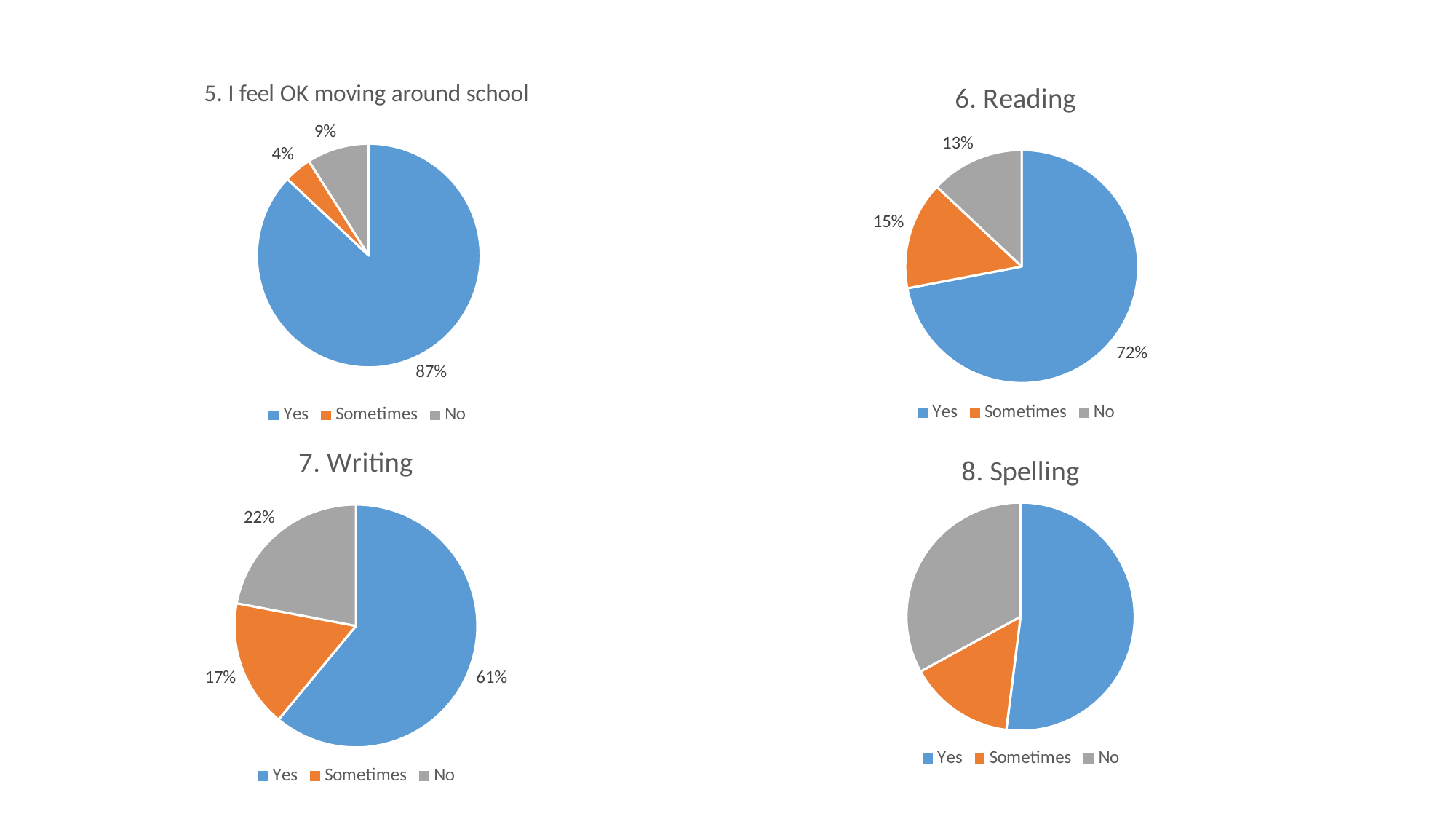
In the chart titled "7. Writing", which category has the smallest slice? Sometimes What kind of chart is the chart titled "7. Writing"? Pie chart In the chart titled "5. I feel OK moving around school", what share of the pie is "Yes"? 87% In the chart titled "6. Reading", which category has the largest slice? Yes In the chart titled "6. Reading", what is the difference between the "Yes" and "Sometimes" values? 57% In the chart titled "7. Writing", what is the value for "No"? 22% How many categories does the legend of the chart titled "6. Reading" list? 3 In the chart titled "7. Writing", which is larger, "Sometimes" or "No"? No In the chart titled "5. I feel OK moving around school", what is the value for "Sometimes"? 4% In the chart titled "8. Spelling", which category has the largest slice? Yes In the chart titled "6. Reading", what is the value for "No"? 13% In the chart titled "8. Spelling", which category has the smallest slice? Sometimes